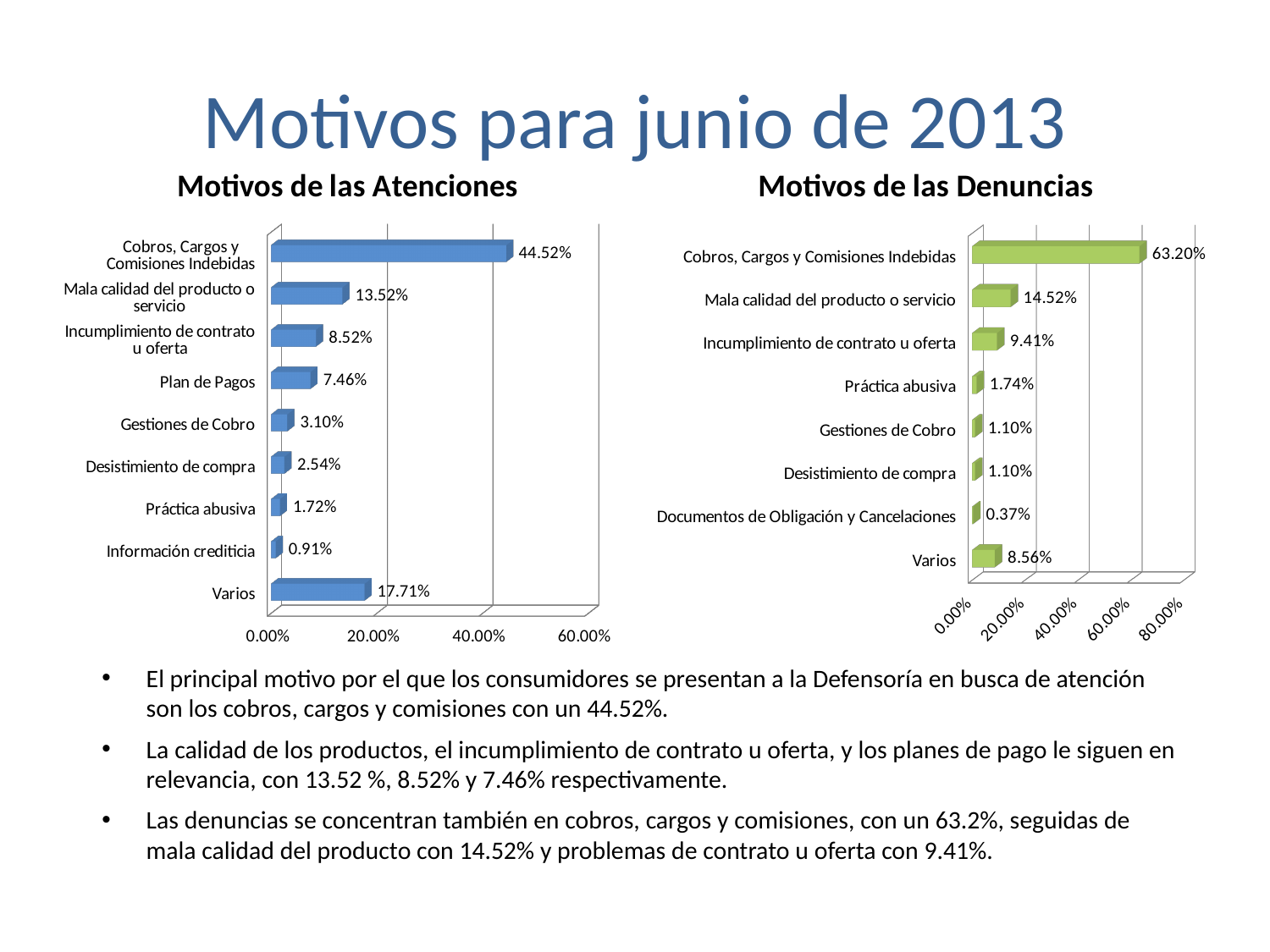
In the 'Motivos de las Denuncias' chart, what is the difference between Cobros, Cargos y Comisiones Indebidas and Varios? 54.64% How many categories are shown in the 'Motivos de las Atenciones' chart? 9 In the 'Motivos de las Atenciones' chart, which category has the lowest value? Información crediticia In the 'Motivos de las Denuncias' chart, which category has the lowest value? Documentos de Obligación y Cancelaciones In the 'Motivos de las Denuncias' chart, which category has the highest value? Cobros, Cargos y Comisiones Indebidas How many categories are shown in the 'Motivos de las Denuncias' chart? 8 In the 'Motivos de las Denuncias' chart, what is the value for Mala calidad del producto o servicio? 14.52% In the 'Motivos de las Atenciones' chart, which is larger: Plan de Pagos or Gestiones de Cobro? Plan de Pagos What kind of chart is the 'Motivos de las Denuncias' chart? Bar chart In the 'Motivos de las Atenciones' chart, what is the difference between Mala calidad del producto o servicio and Incumplimiento de contrato u oferta? 5.00% In the 'Motivos de las Denuncias' chart, is the value for Cobros, Cargos y Comisiones Indebidas greater or less than 60.00%? greater In the 'Motivos de las Atenciones' chart, what is the value for Cobros, Cargos y Comisiones Indebidas? 44.52%